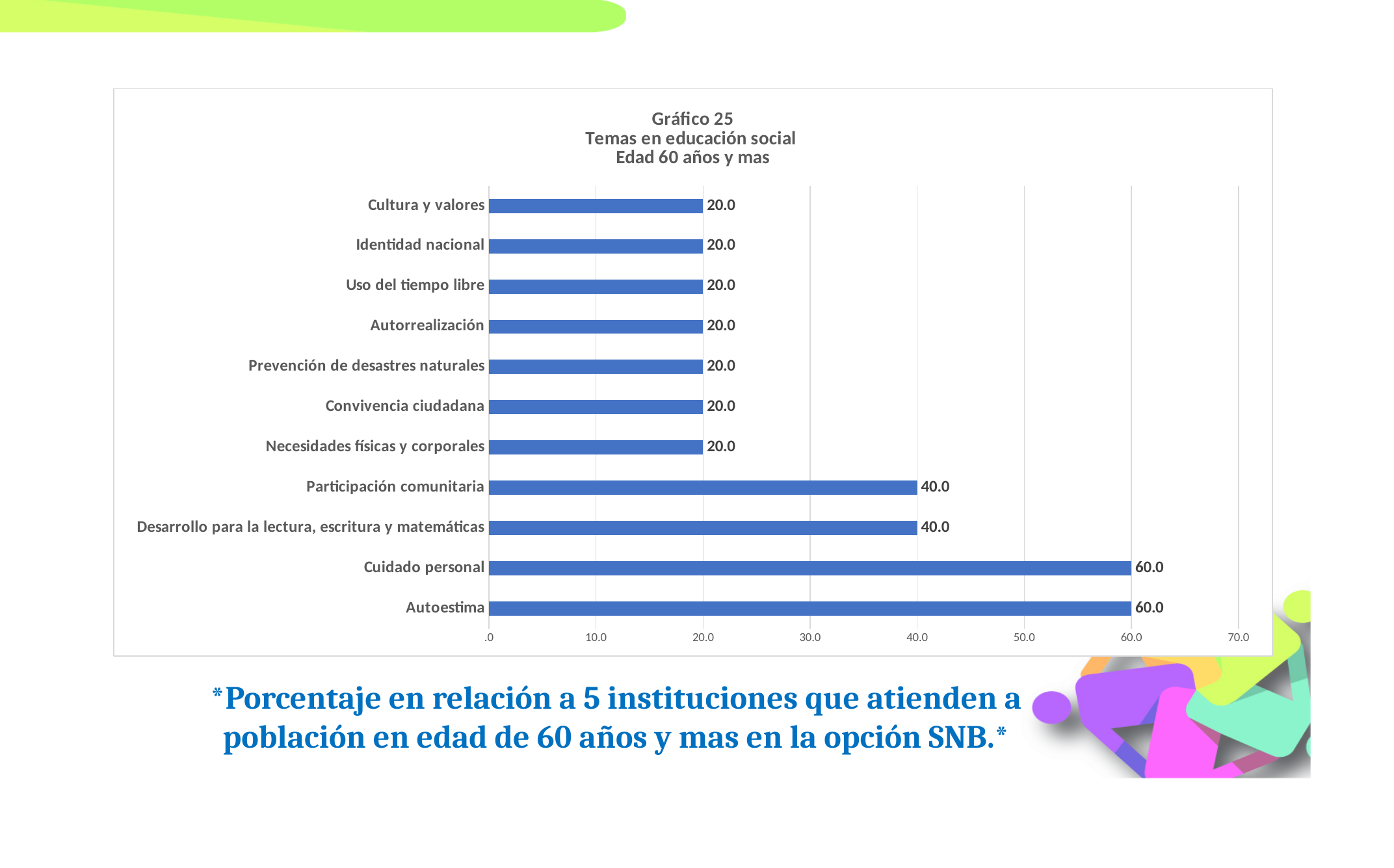
What is the title of the chart? Gráfico 25 Temas en educación social Edad 60 años y mas What is the value for Desarrollo para la lectura, escritura y matemáticas? 40.0 What is the value for Cultura y valores? 20.0 What is the value for Participación comunitaria? 40.0 What is the difference between the values for Participación comunitaria and Identidad nacional? 20.0 How many categories have a value of 20.0? 7 Which is larger, the value for Cuidado personal or the value for Participación comunitaria? Cuidado personal What kind of chart is shown on the slide? Bar chart What is the value for Cuidado personal? 60.0 Which is larger, the value for Uso del tiempo libre or the value for Desarrollo para la lectura, escritura y matemáticas? Desarrollo para la lectura, escritura y matemáticas What is the difference between the values for Autoestima and Convivencia ciudadana? 40.0 How many categories are shown in the chart? 11